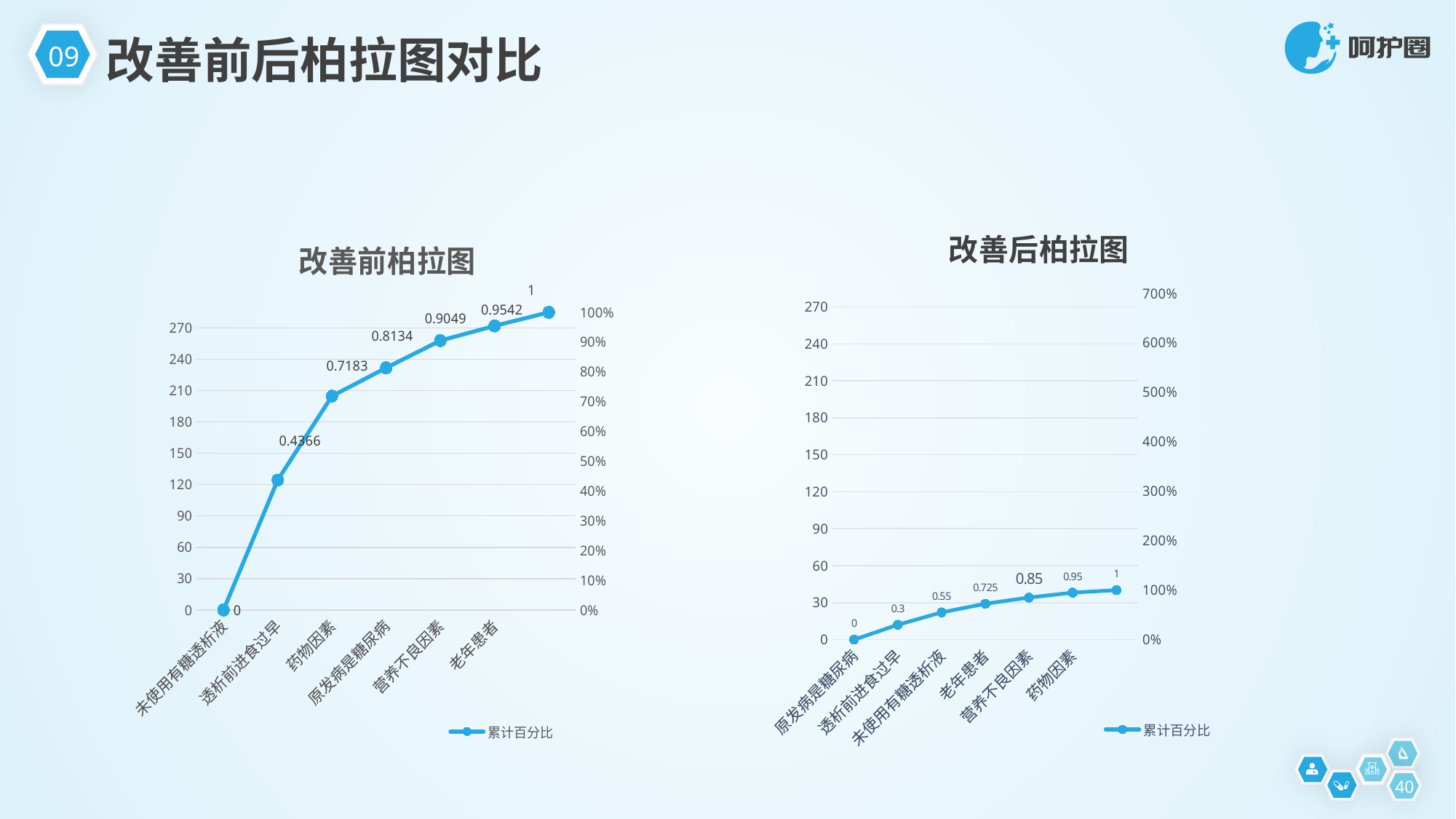
How many data points are plotted on the line in the 改善后柏拉图 chart? 7 How many series does the legend of the 改善前柏拉图 chart list? 1 In the 改善前柏拉图 chart, what is the cumulative percentage value labelled for 透析前进食过早? 0.4366 What kind of chart is the 改善后柏拉图 chart? Line chart In the 改善前柏拉图 chart, what is the value labelled for 药物因素? 0.7183 In the 改善前柏拉图 chart, which is larger: the value for 原发病是糖尿病 or the value for 老年患者? 老年患者 In the 改善后柏拉图 chart, what is the value labelled for 药物因素? 0.95 In the 改善前柏拉图 chart, what is the value labelled for 营养不良因素? 0.9049 In the 改善后柏拉图 chart, what is the difference between the values for 营养不良因素 and 透析前进食过早? 0.55 In the 改善前柏拉图 chart, do the values rise or fall from left to right along the x axis? Rise In the 改善前柏拉图 chart, what is the difference between the values for 药物因素 and 透析前进食过早? 0.2817 In the 改善后柏拉图 chart, what is the value labelled for 老年患者? 0.725